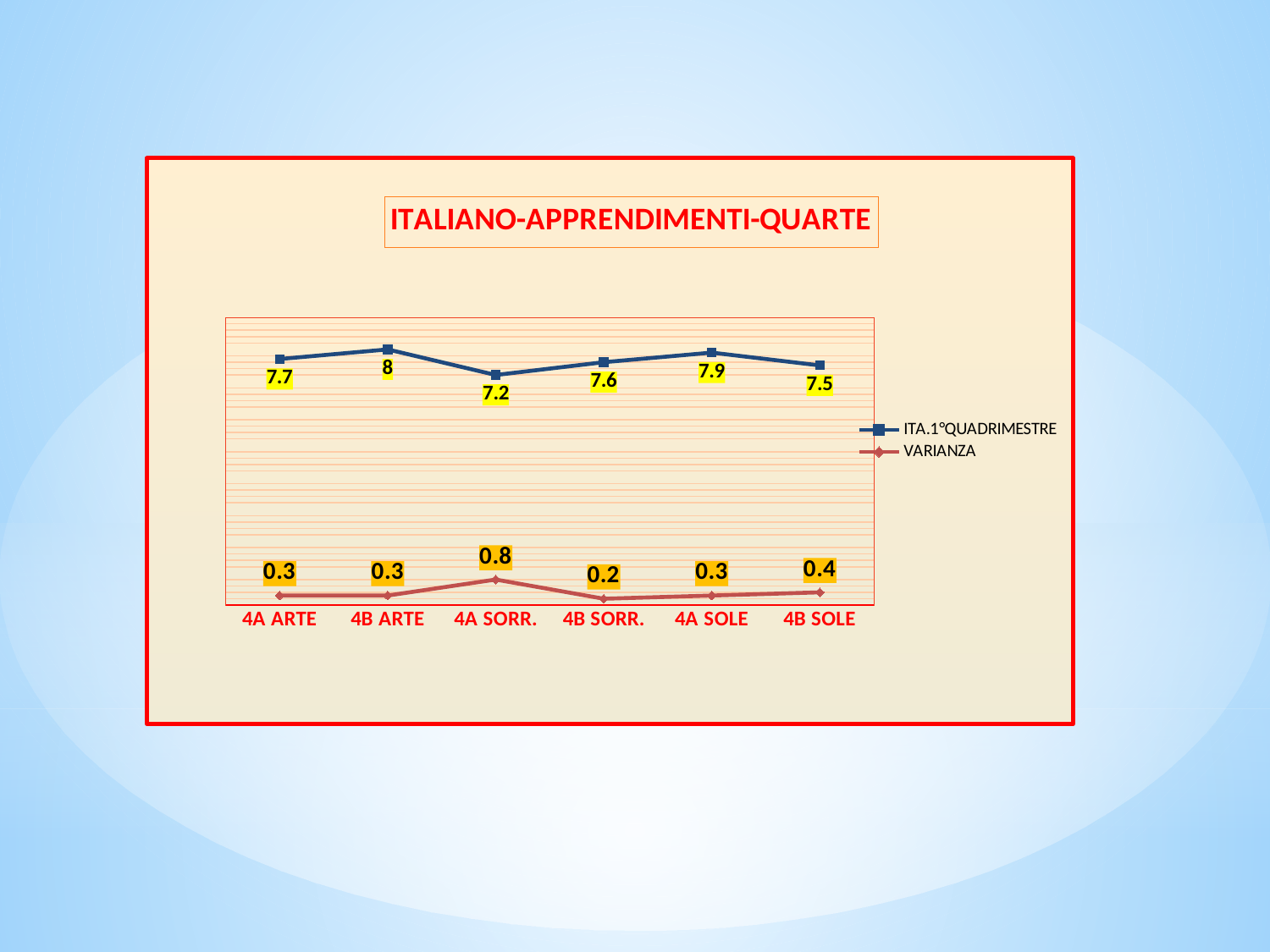
How many series does the legend list? 2 What is the ITA.1°QUADRIMESTRE value for 4A SORR.? 7.2 How many categories are shown on the x axis? 6 What is the ITA.1°QUADRIMESTRE value for 4B ARTE? 8 What kind of chart is shown on the slide? Line chart What is the title of the chart? ITALIANO-APPRENDIMENTI-QUARTE What is the VARIANZA value for 4A SORR.? 0.8 Which category has the lowest VARIANZA value? 4B SORR. Which category has the highest ITA.1°QUADRIMESTRE value? 4B ARTE What is the difference between the ITA.1°QUADRIMESTRE values for 4B ARTE and 4A SORR.? 0.8 Which category has the lowest ITA.1°QUADRIMESTRE value? 4A SORR. Which is larger, the ITA.1°QUADRIMESTRE value for 4A SOLE or for 4B SOLE? 4A SOLE